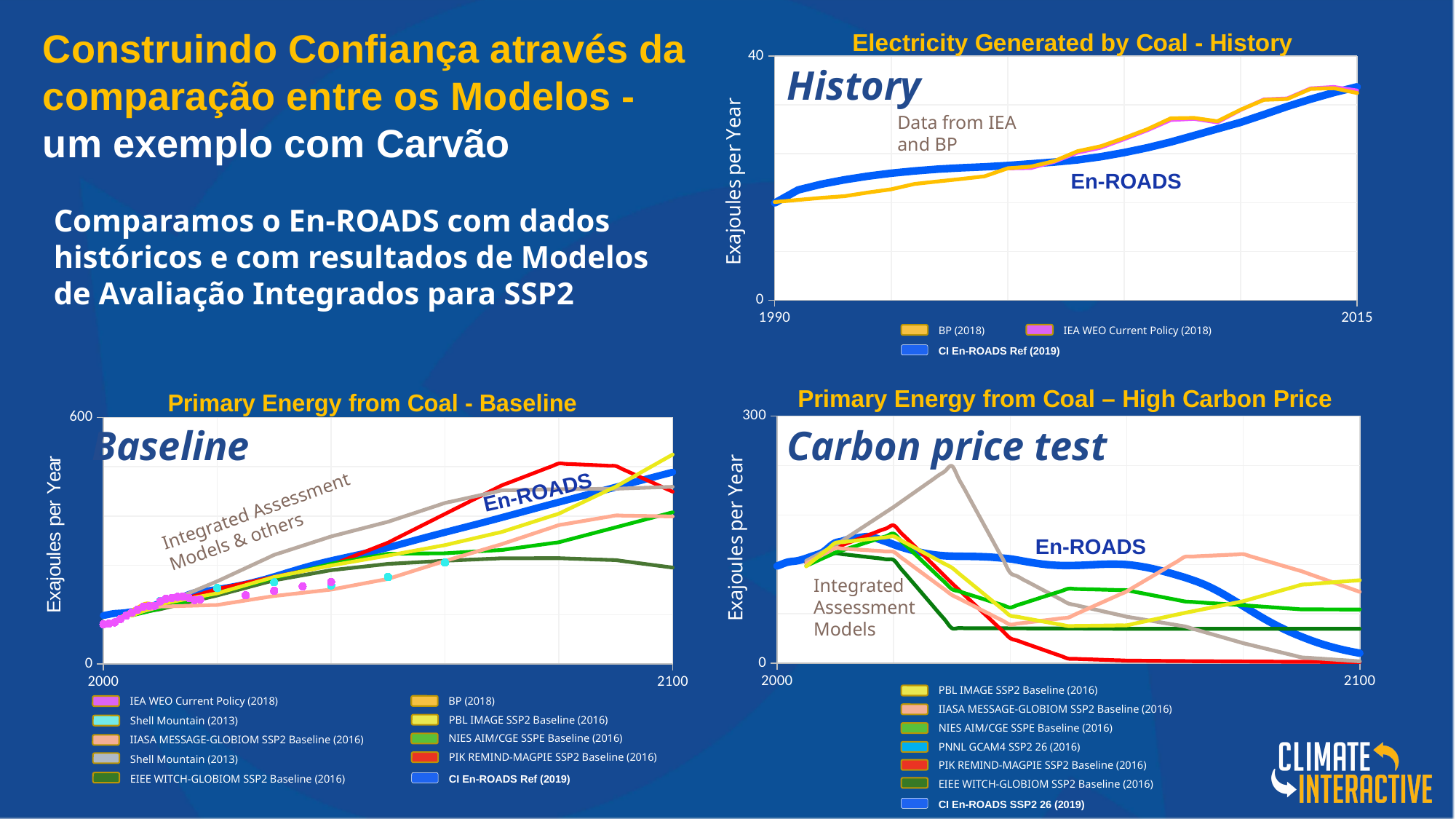
What kind of chart is the 'Electricity Generated by Coal - History' chart? line chart In the 'Primary Energy from Coal - Baseline' chart, which is higher in 2100: PBL IMAGE SSP2 Baseline (2016) or CI En-ROADS Ref (2019)? PBL IMAGE SSP2 Baseline (2016) In the 'Electricity Generated by Coal - History' chart, is the En-ROADS value in 2015 greater or less than 40? less How many series does the legend of the 'Electricity Generated by Coal - History' chart list? 3 What is the y-axis label of the 'Electricity Generated by Coal - History' chart? Exajoules per Year In the 'Electricity Generated by Coal - History' chart, does the En-ROADS line rise or fall from 1990 to 2015? rise In the 'Primary Energy from Coal - Baseline' chart, does the En-ROADS line rise or fall from 2000 to 2100? rise How many series does the legend of the 'Primary Energy from Coal – High Carbon Price' chart list? 7 In the 'Primary Energy from Coal – High Carbon Price' chart, does the En-ROADS line rise or fall overall from 2000 to 2100? fall How many series does the legend of the 'Primary Energy from Coal - Baseline' chart list? 10 In the 'Primary Energy from Coal – High Carbon Price' chart, which is higher in 2100: IIASA MESSAGE-GLOBIOM SSP2 Baseline (2016) or CI En-ROADS SSP2 26 (2019)? IIASA MESSAGE-GLOBIOM SSP2 Baseline (2016) What kind of chart is the 'Primary Energy from Coal - Baseline' chart? line chart